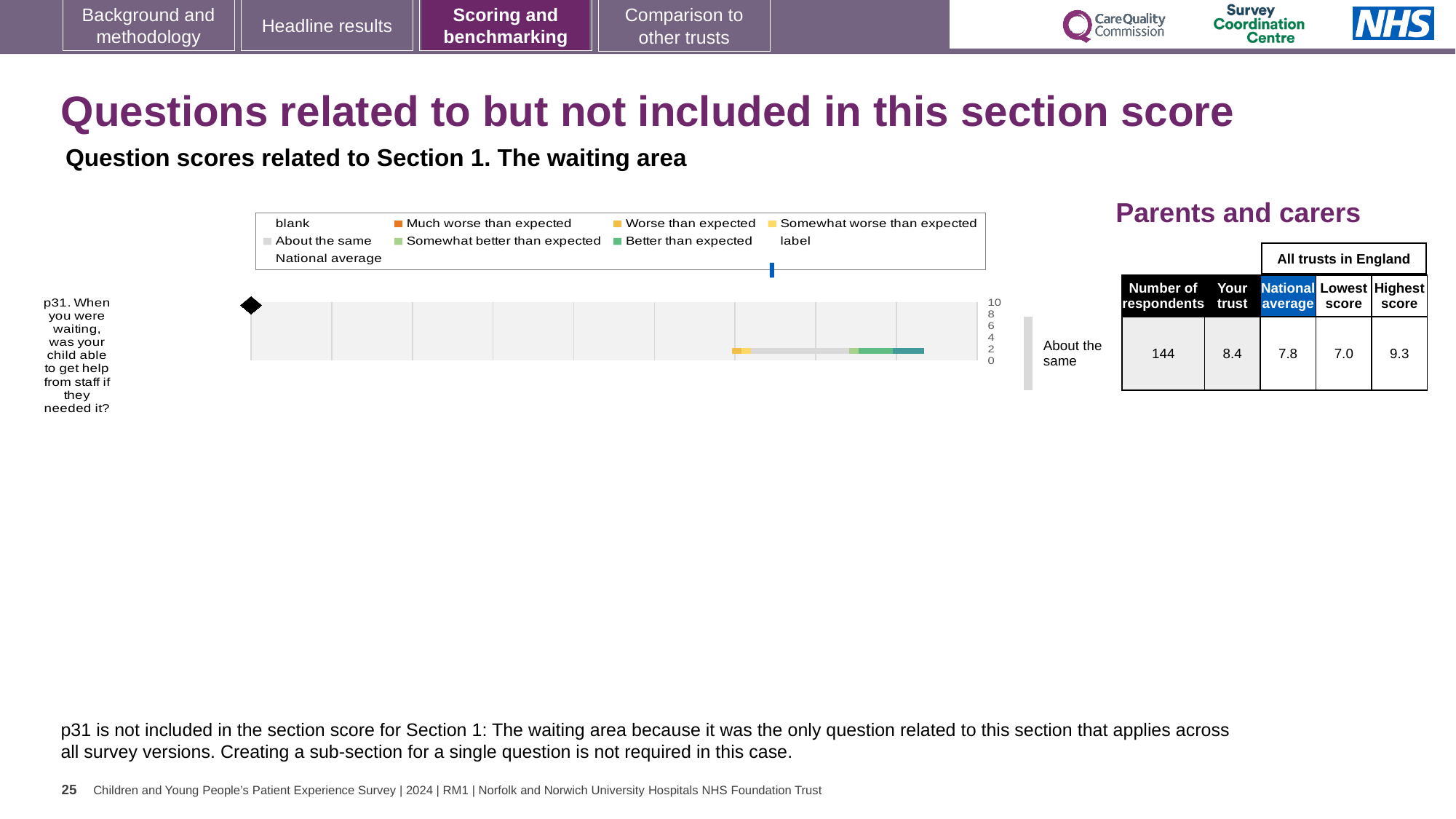
In the table next to the chart, what is the Highest score among all trusts in England for p31? 9.3 What is the maximum value shown on the chart's axis? 10 What is the difference between the Highest score and the Lowest score for p31 in the table? 2.3 In the table next to the chart, how many respondents answered p31? 144 Is the 'Your trust' score for p31 higher or lower than the National average? Higher Which question is plotted in the chart? p31. When you were waiting, was your child able to get help from staff if they needed it? In the table next to the chart, what is the National average score for p31? 7.8 In the table next to the chart, what is the 'Your trust' score for p31? 8.4 What kind of chart is shown on the slide for question p31? Bar chart How many questions (categories) are plotted in the chart? 1 What benchmark category label is shown to the right of the chart for p31? About the same In the table next to the chart, what is the Lowest score among all trusts in England for p31? 7.0